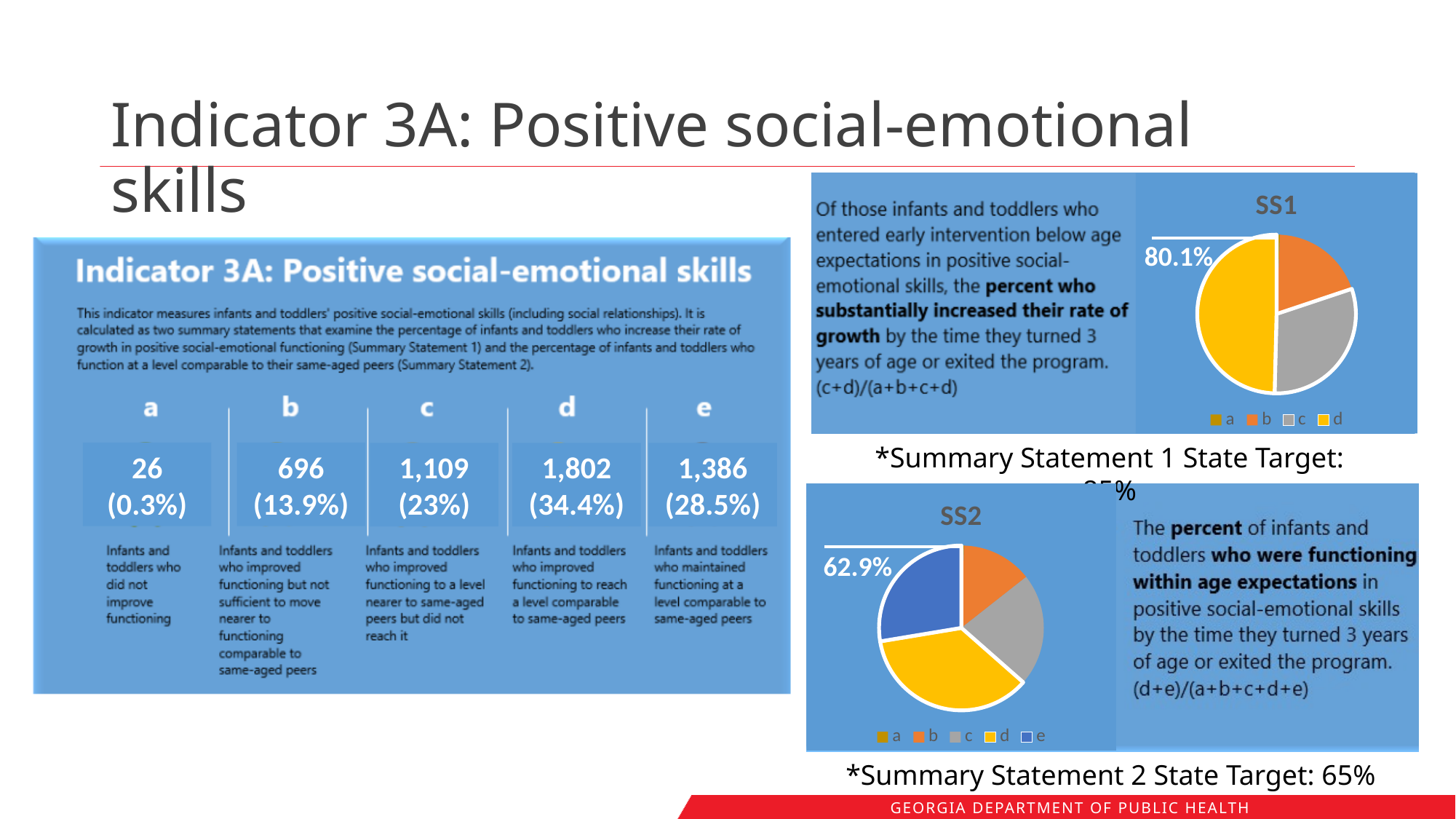
How many series does the legend of the SS2 chart list? 5 What percentage is labelled on the SS2 pie chart? 62.9% In the SS1 pie chart, which slice is larger, b or c? c In the SS2 pie chart, which category has the largest slice? d In the SS1 pie chart, which category has the largest slice? d What percentage is labelled on the SS1 pie chart? 80.1% What is the title of the pie chart in the upper right of the slide? SS1 What kind of chart is the SS2 chart? pie chart In the SS2 pie chart, which slice is larger, b or d? d What colour is the slice for category d in the SS2 pie chart? yellow How many series does the legend of the SS1 chart list? 4 What kind of chart is the SS1 chart? pie chart